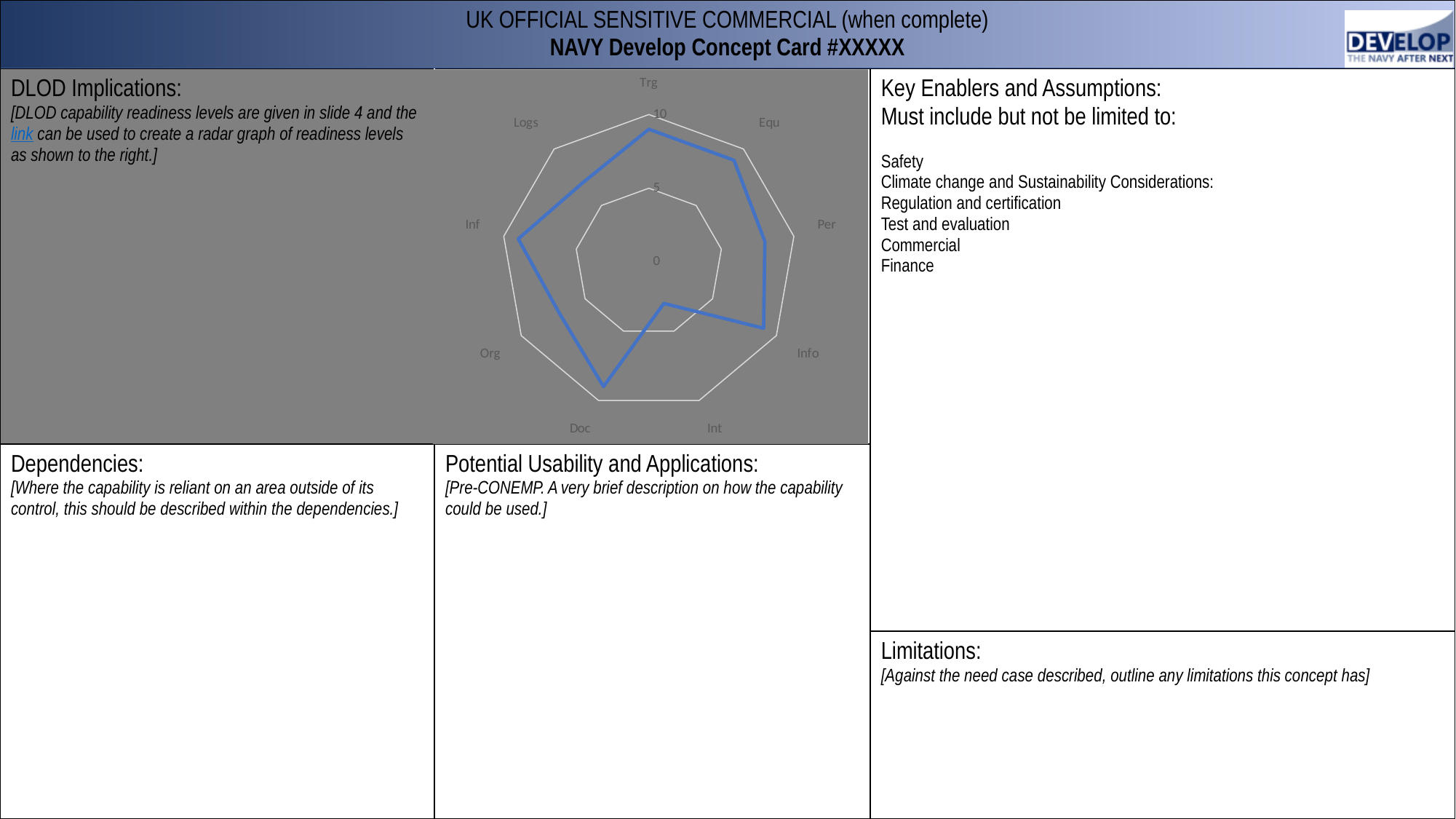
How many categories (axes) does the radar chart have? 9 What kind of chart is shown on the slide? radar chart Which category has the lowest value on the radar chart? Int Is the value for Int greater or less than 5? less Is the value for Inf greater or less than 5? greater Is the value for Info greater or less than 5? greater What colour is the plotted data line on the radar chart? blue Which is larger, the value for Info or the value for Int? Info What is the highest tick value shown on the radar chart's scale? 10